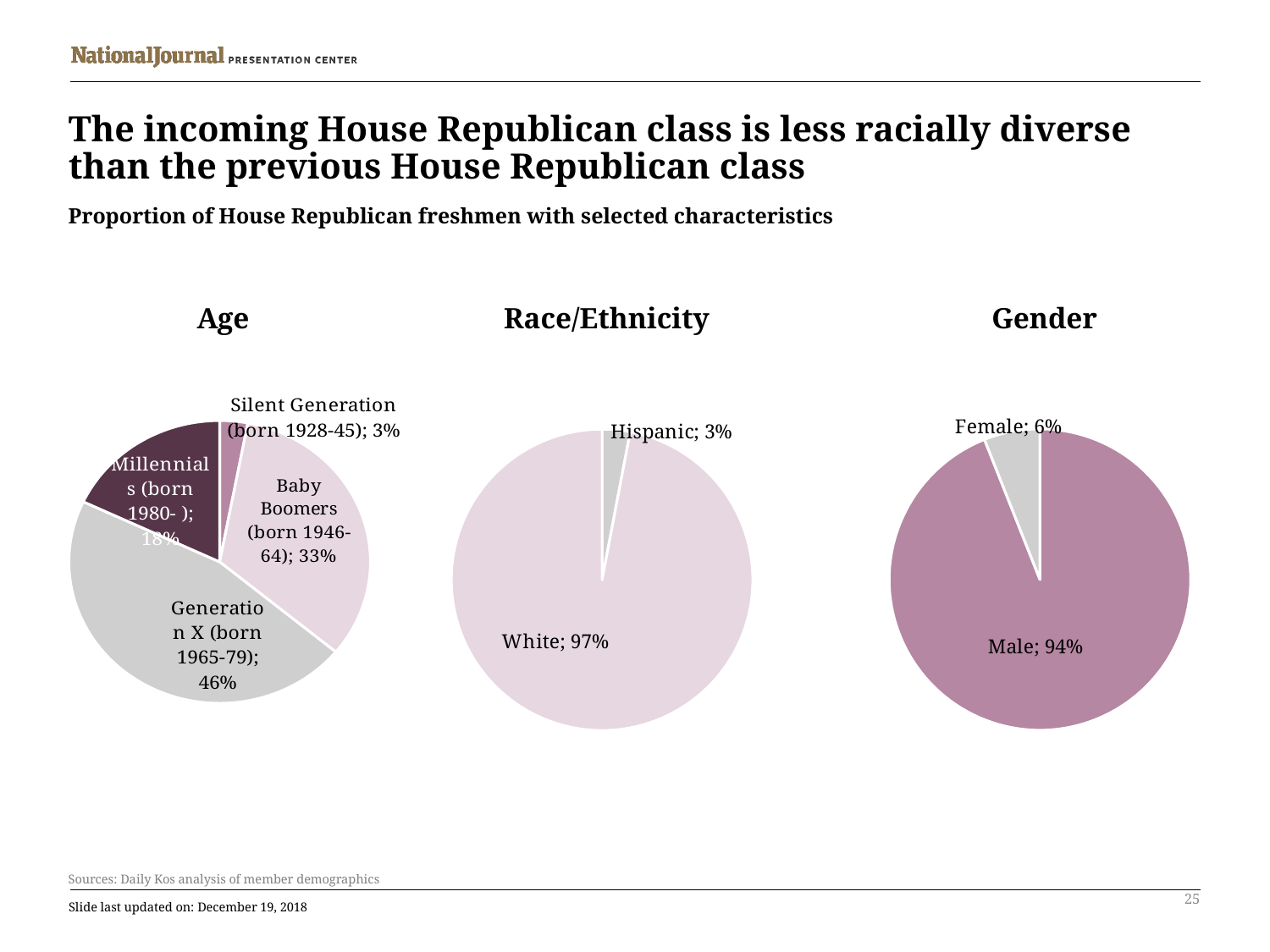
In the Age chart, what share of House Republican freshmen are Baby Boomers (born 1946-64)? 33% In the Age chart, how many slices does the pie have? 4 In the Age chart, which generation has the smallest share? Silent Generation (born 1928-45) In the Race/Ethnicity chart, what share of House Republican freshmen are White? 97% In the Age chart, how many percentage points larger is the Generation X share than the Baby Boomers share? 13 In the Gender chart, how many percentage points larger is the Male share than the Female share? 88 What type of chart is used for the Gender breakdown? Pie chart In the Gender chart, what share of House Republican freshmen are female? 6% In the Race/Ethnicity chart, what share of House Republican freshmen are Hispanic? 3% In the Age chart, which generation has the largest share? Generation X (born 1965-79) In the Age chart, what share of House Republican freshmen are Generation X (born 1965-79)? 46% In the Age chart, what share of House Republican freshmen are from the Silent Generation (born 1928-45)? 3%